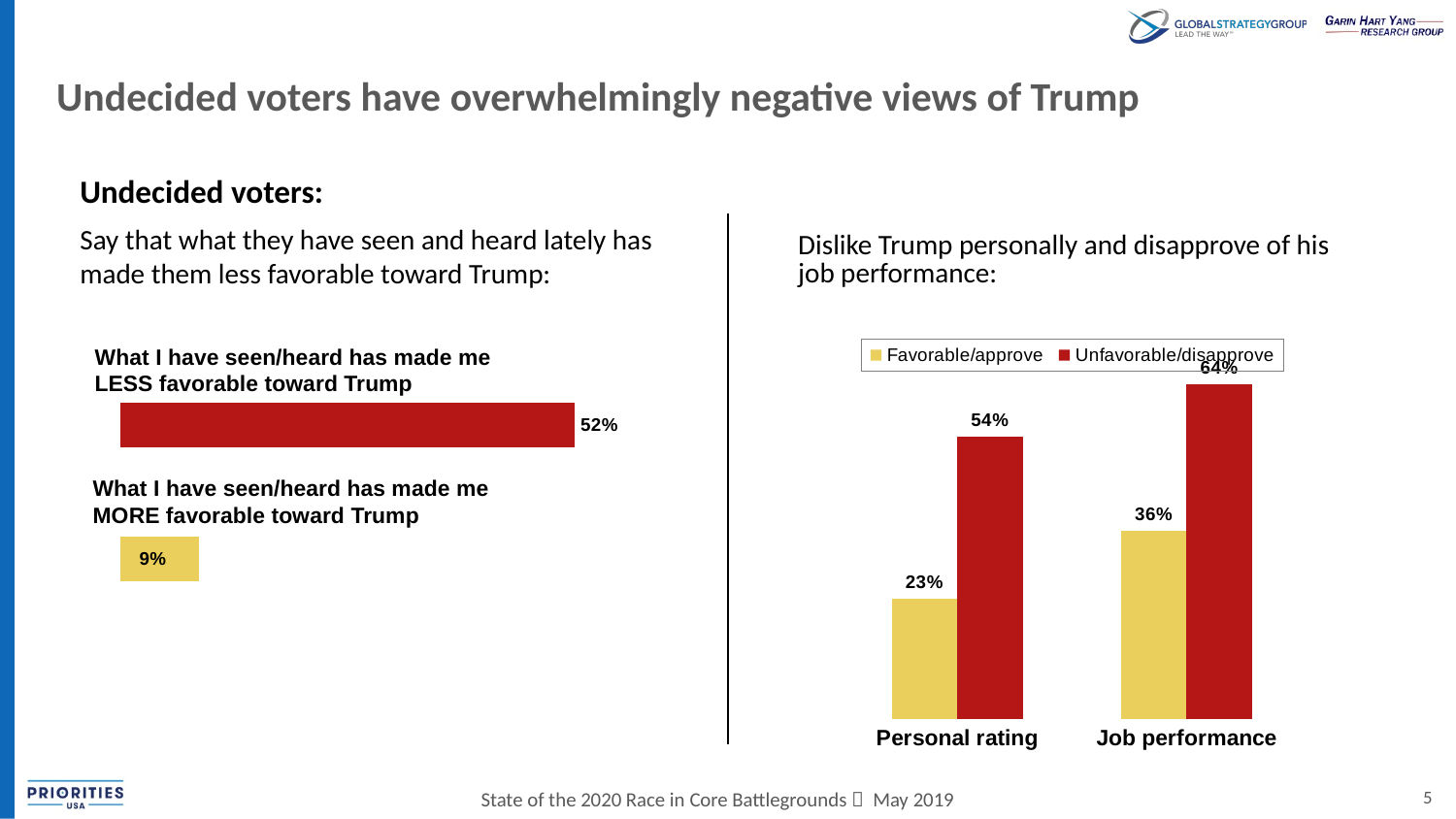
In the left chart, what percentage say what they have seen/heard has made them MORE favorable toward Trump? 9% In the right chart, what is the difference between Unfavorable/disapprove and Favorable/approve for Personal rating? 31 percentage points In the right chart, what colour represents Unfavorable/disapprove? Red In the left chart, what is the difference between the LESS favorable and MORE favorable percentages? 43 percentage points In the right chart, what is the Unfavorable/disapprove value for Job performance? 64% In the right chart, what is the Favorable/approve value for Job performance? 36% How many series does the legend of the right chart list? 2 What kind of chart is the left chart? Bar chart In the left chart, what percentage of undecided voters say what they have seen/heard has made them LESS favorable toward Trump? 52% In the left chart, which response has the larger value: LESS favorable or MORE favorable? LESS favorable toward Trump In the right chart, which bar is the highest? Unfavorable/disapprove for Job performance (64%) In the right chart, what is the Favorable/approve value for Personal rating? 23%